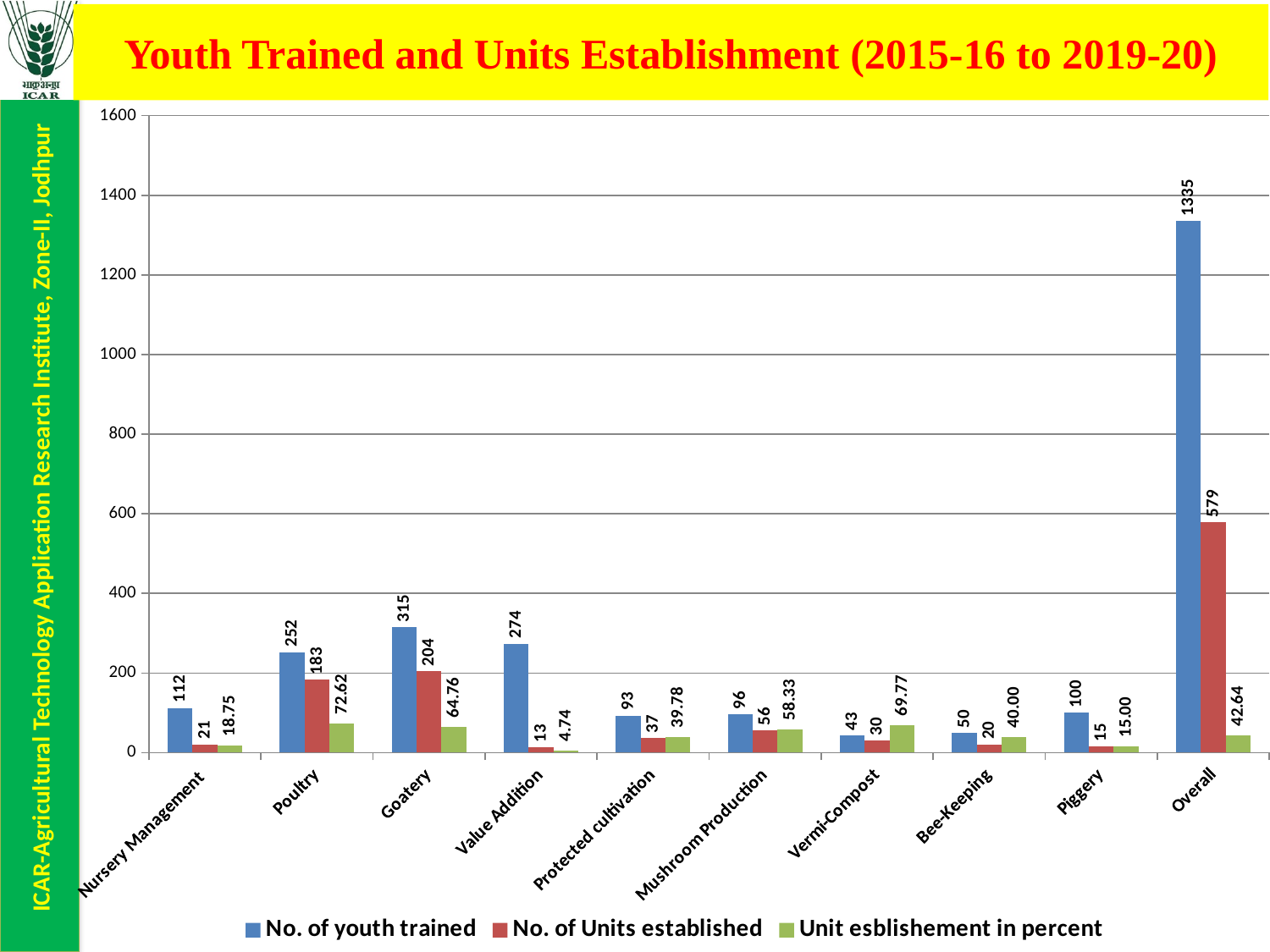
Is the Overall number of youth trained greater or less than 1200? greater Which is larger: the number of units established for Goatery or for Poultry? Goatery How many units were established for Poultry? 183 What kind of chart is shown on the slide? bar chart How many youth were trained in Goatery? 315 How many categories are shown on the x axis? 10 Excluding Overall, which category has the highest number of youth trained? Goatery What is the difference between the number of youth trained and the number of units established for Value Addition? 261 Which category has the lowest unit establishment in percent? Value Addition What is the title of the chart? Youth Trained and Units Establishment (2015-16 to 2019-20) What is the unit establishment in percent for Vermi-Compost? 69.77 How many series does the legend list? 3